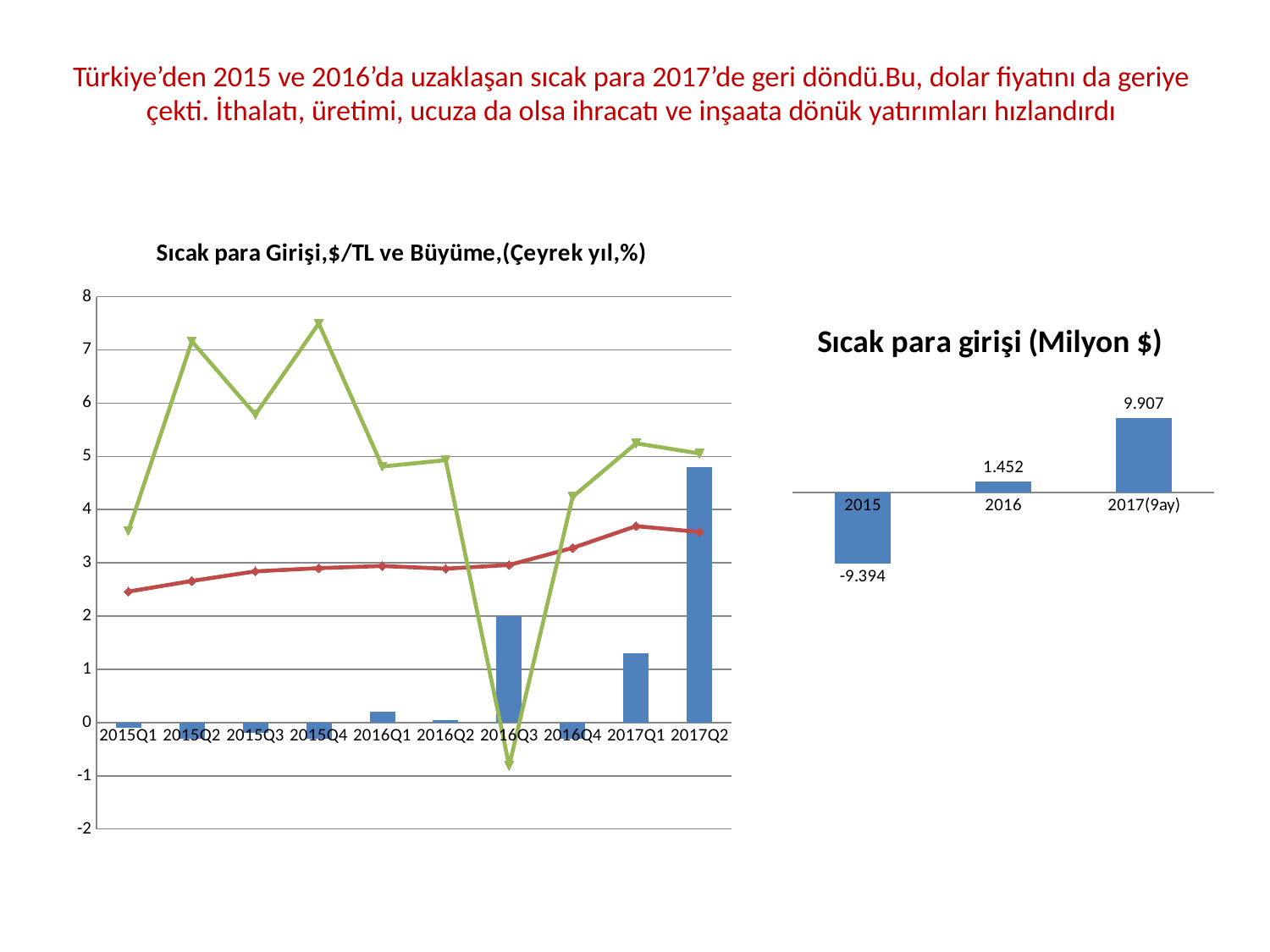
In the chart on the left, is the bar for 2017Q2 greater or less than 4? greater What kind of chart is the one titled 'Sıcak para girişi (Milyon $)'? Bar chart In the chart on the left, is the green line's value at 2016Q3 greater or less than 0? less In the chart titled 'Sıcak para girişi (Milyon $)', what is the value for 2015? -9.394 In the chart on the left, which quarter has the tallest bar? 2017Q2 In the chart titled 'Sıcak para girişi (Milyon $)', what is the difference between the values for 2017(9ay) and 2016? 8.455 In the chart titled 'Sıcak para girişi (Milyon $)', what is the value for 2017(9ay)? 9.907 In the chart on the left, how many quarters are shown on the x axis? 10 In the chart titled 'Sıcak para girişi (Milyon $)', how many categories are shown? 3 In the chart titled 'Sıcak para girişi (Milyon $)', what is the value for 2016? 1.452 In the chart titled 'Sıcak para girişi (Milyon $)', which category has the highest value? 2017(9ay) In the chart titled 'Sıcak para girişi (Milyon $)', which category has the lowest value? 2015